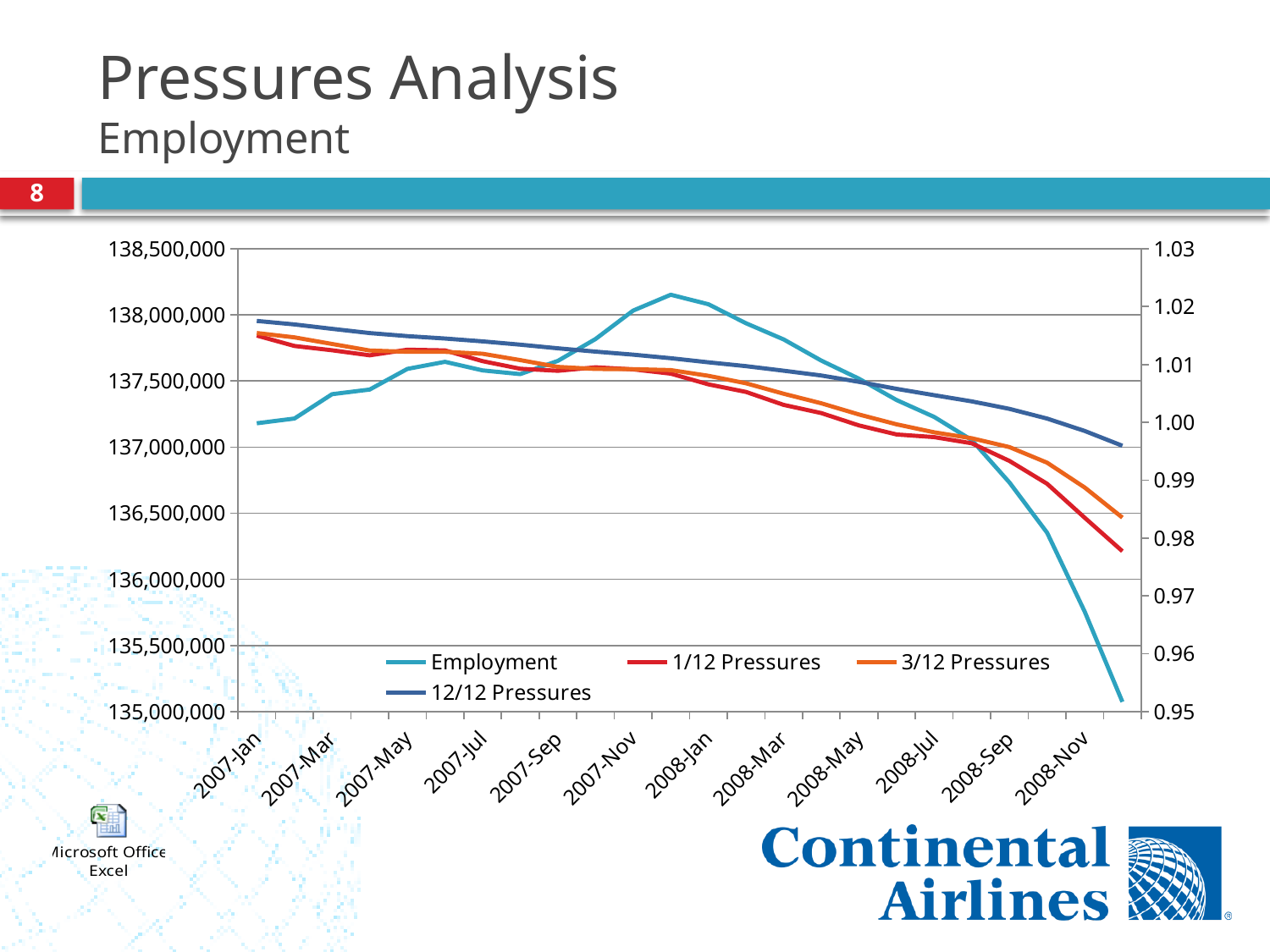
How many series does the legend list? 4 Which series is plotted in dark blue according to the legend? 12/12 Pressures Is the 12/12 Pressures value at 2007-Jan greater or less than 1.01? greater Does the 12/12 Pressures line rise or fall from 2007-Jan to the end of the chart? fall Which of the three Pressures series is lowest at the last point on the chart? 1/12 Pressures Is the peak Employment value around 2008-Jan greater or less than 138,000,000? greater Is the 12/12 Pressures value at the last point on the chart greater or less than 1.00? less What is the subtitle of the slide beneath 'Pressures Analysis'? Employment At the last point on the chart, which is higher: 12/12 Pressures or 1/12 Pressures? 12/12 Pressures What kind of chart is shown on the slide? line chart